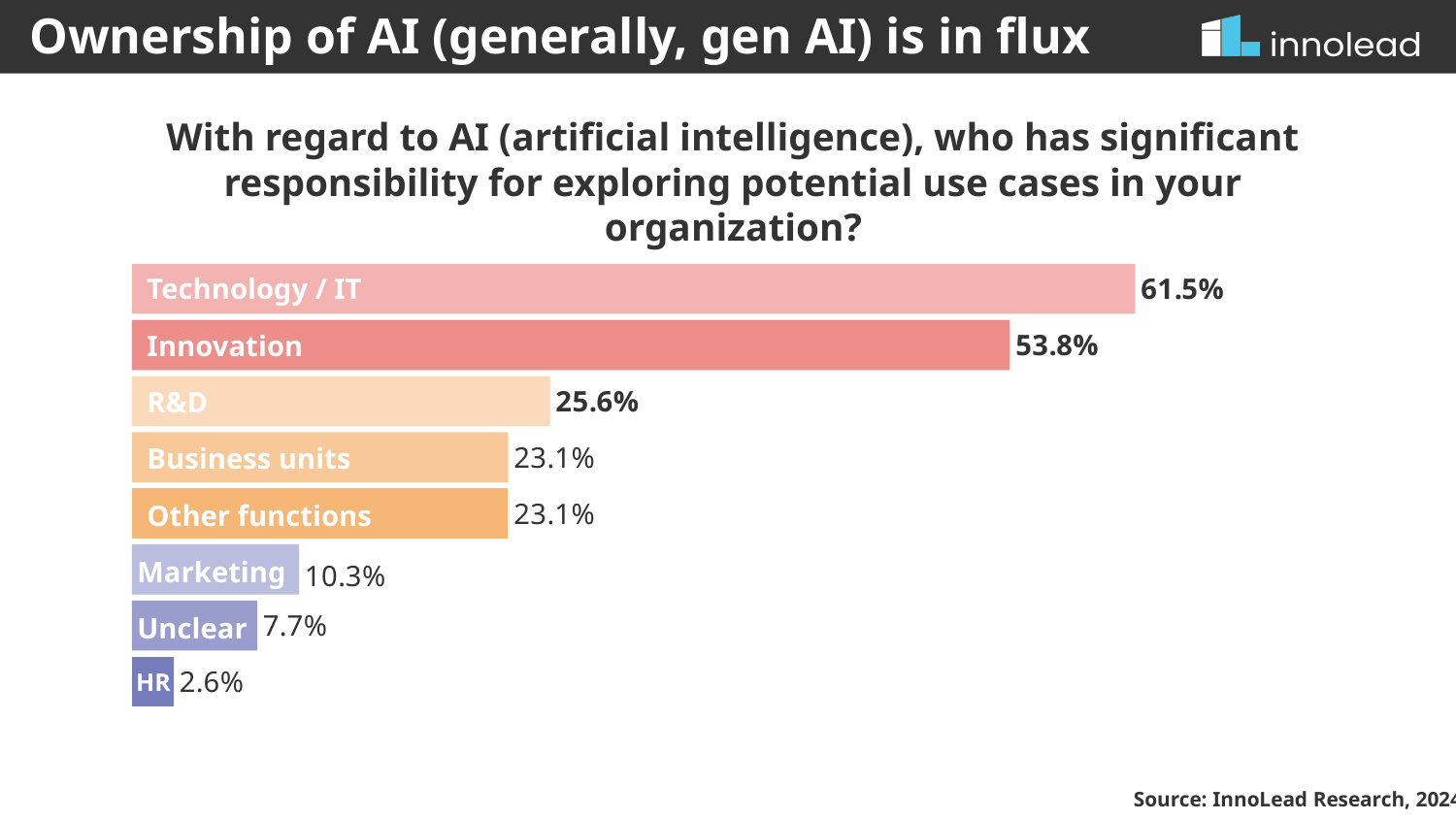
What is the difference between the values for R&D and HR? 23.0% Which two categories share the same value of 23.1%? Business units and Other functions What is the value for Marketing? 10.3% What percentage is shown for R&D? 25.6% What percentage is shown for Technology / IT? 61.5% What is the difference between the values for Technology / IT and Innovation? 7.7% What kind of chart is shown on the slide? Bar chart What is the value for Innovation? 53.8% Which category has the lowest value? HR How many categories are shown in the chart? 8 Which category has the highest value? Technology / IT Which is larger, the value for Innovation or the value for R&D? Innovation